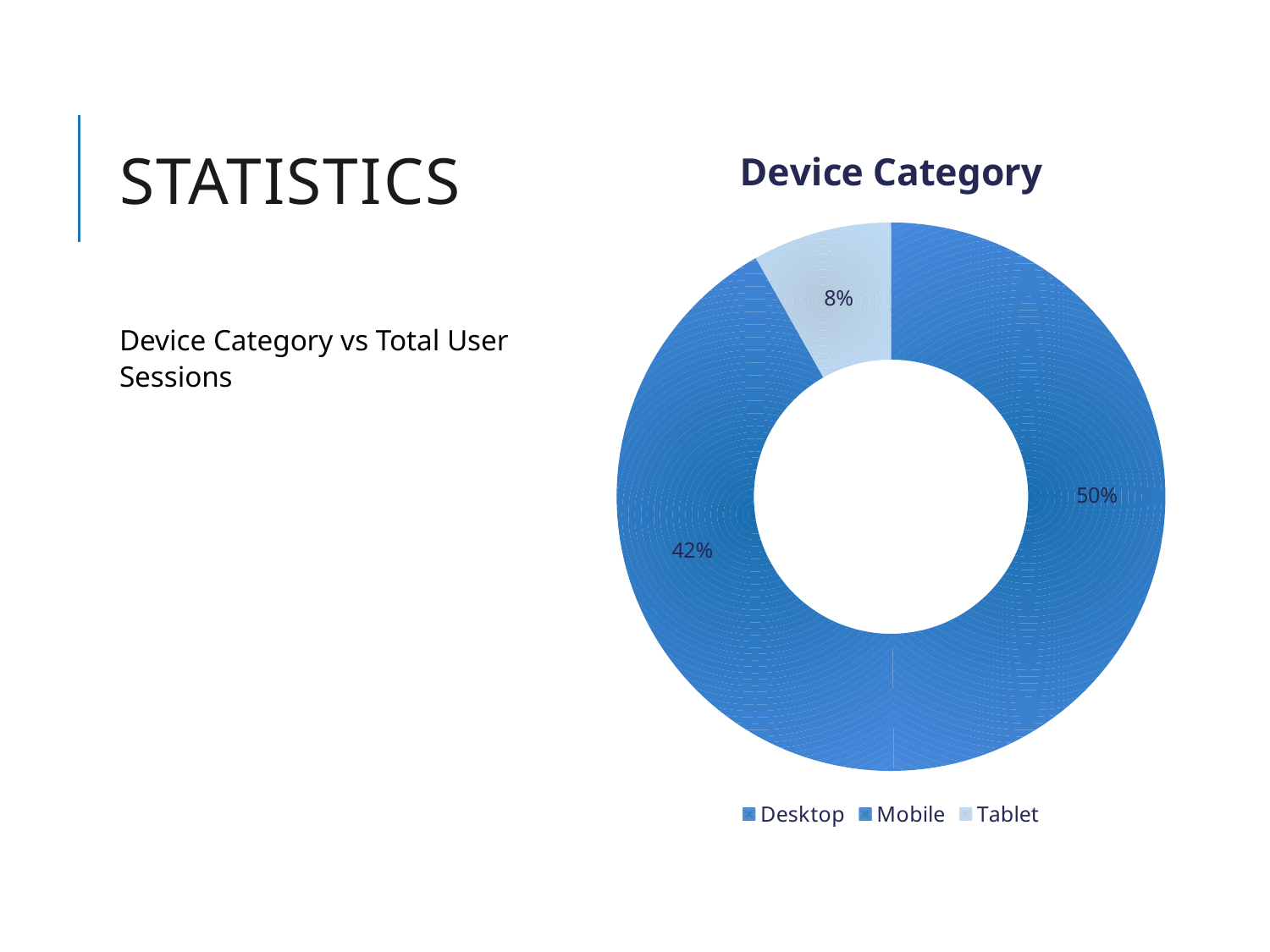
What is the difference in percentage points between the Desktop and Mobile shares? 8 Which legend entry is shown in the lightest shade of blue? Tablet Which category has the largest share in the Device Category chart? Desktop What share of the Device Category chart does Mobile account for? 42% What kind of chart is shown on the slide? doughnut chart What is the difference in percentage points between the Mobile and Tablet shares? 34 What share of the Device Category chart does Tablet account for? 8% Which has a larger share, Mobile or Tablet? Mobile How many categories does the legend of the Device Category chart list? 3 What is the title of the chart? Device Category What share of the Device Category chart does Desktop account for? 50% Which category has the smallest share in the Device Category chart? Tablet